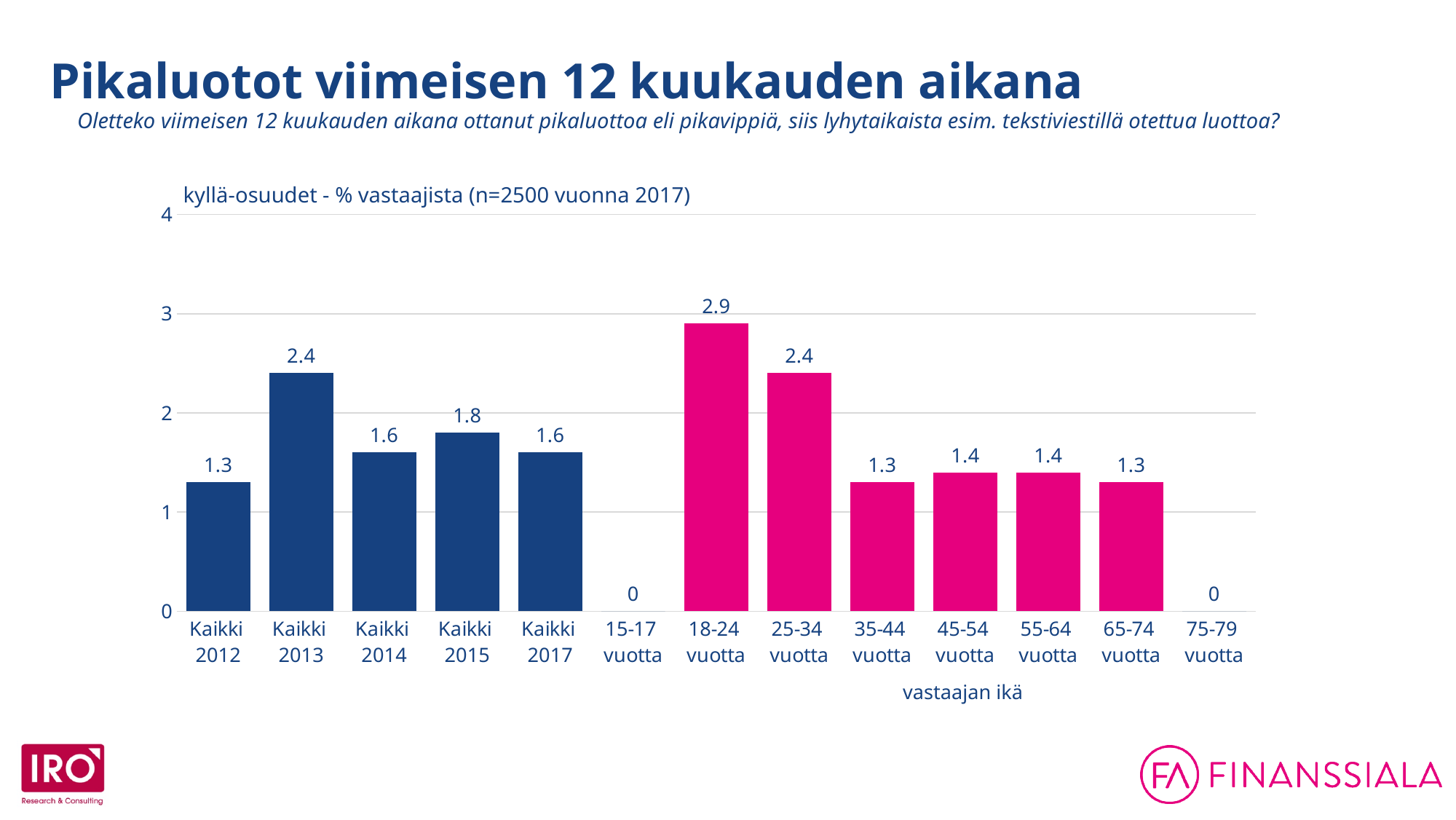
What is the value for the 75-79 vuotta age group? 0 Is the value for 18-24 vuotta greater or less than 2? greater What is the value for Kaikki 2013? 2.4 What is the value for the 18-24 vuotta age group? 2.9 Which is larger, the value for Kaikki 2015 or the value for Kaikki 2014? Kaikki 2015 Among the Kaikki bars, which year has the lowest value? Kaikki 2012 What kind of chart is shown on the slide? bar chart What is the x-axis label under the age group bars? vastaajan ikä Which category has the highest value? 18-24 vuotta What is the difference between the values for 18-24 vuotta and 25-34 vuotta? 0.5 What is the value for Kaikki 2017? 1.6 How many categories are shown on the x axis? 13